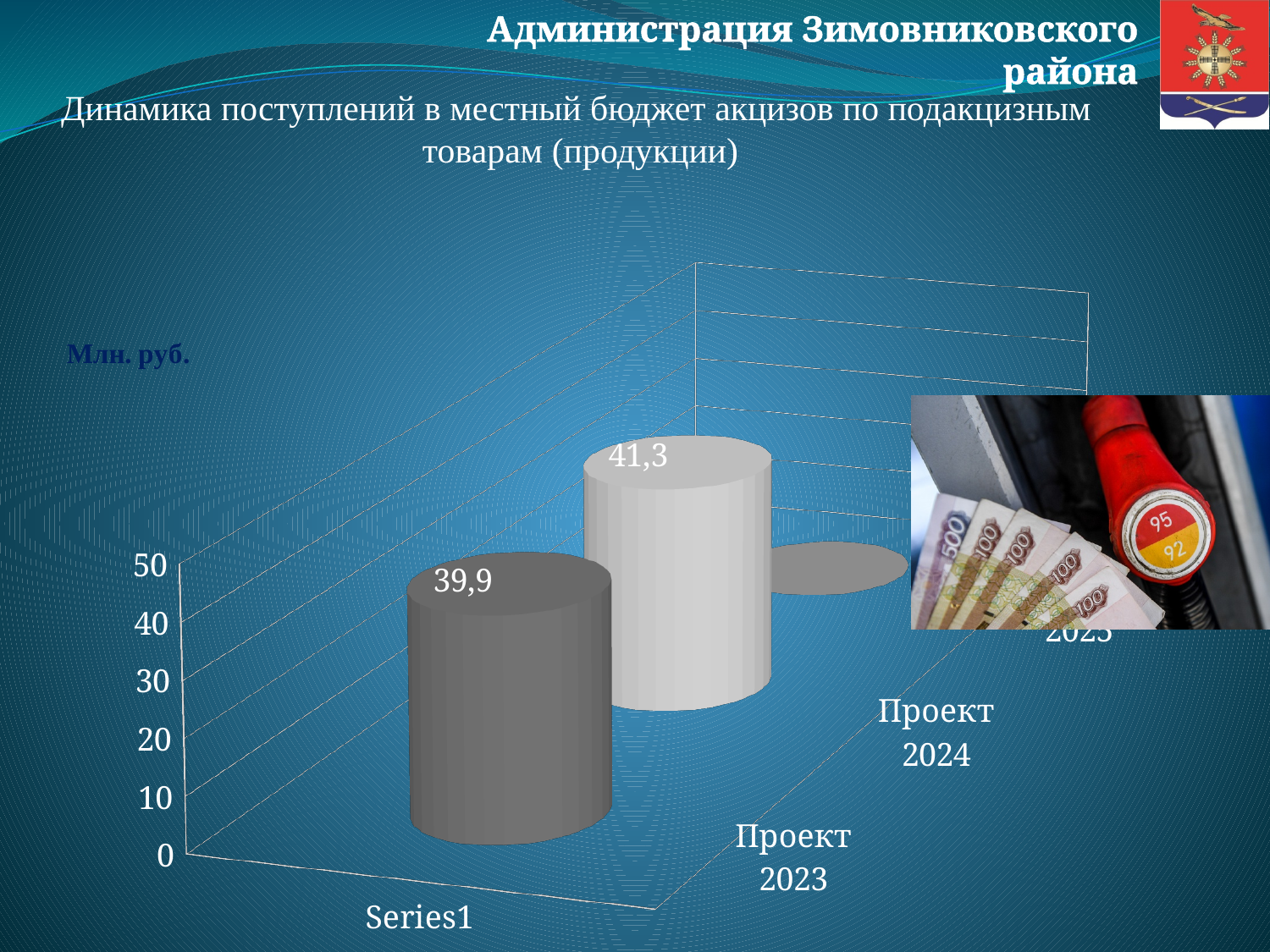
What is the difference between the values for Проект 2024 and Проект 2023? 1,4 What is the value for Проект 2024? 41,3 What unit label is shown next to the vertical axis? Млн. руб. What series name is shown at the bottom of the chart? Series1 Which category has the highest value? Проект 2024 Which is larger, the value for Проект 2023 or Проект 2024? Проект 2024 Is the value for Проект 2023 greater or less than 30? greater Is the value for Проект 2024 greater or less than 50? less Do the values rise or fall from Проект 2023 to Проект 2024? rise What kind of chart is shown on the slide? bar chart What is the value for Проект 2023? 39,9